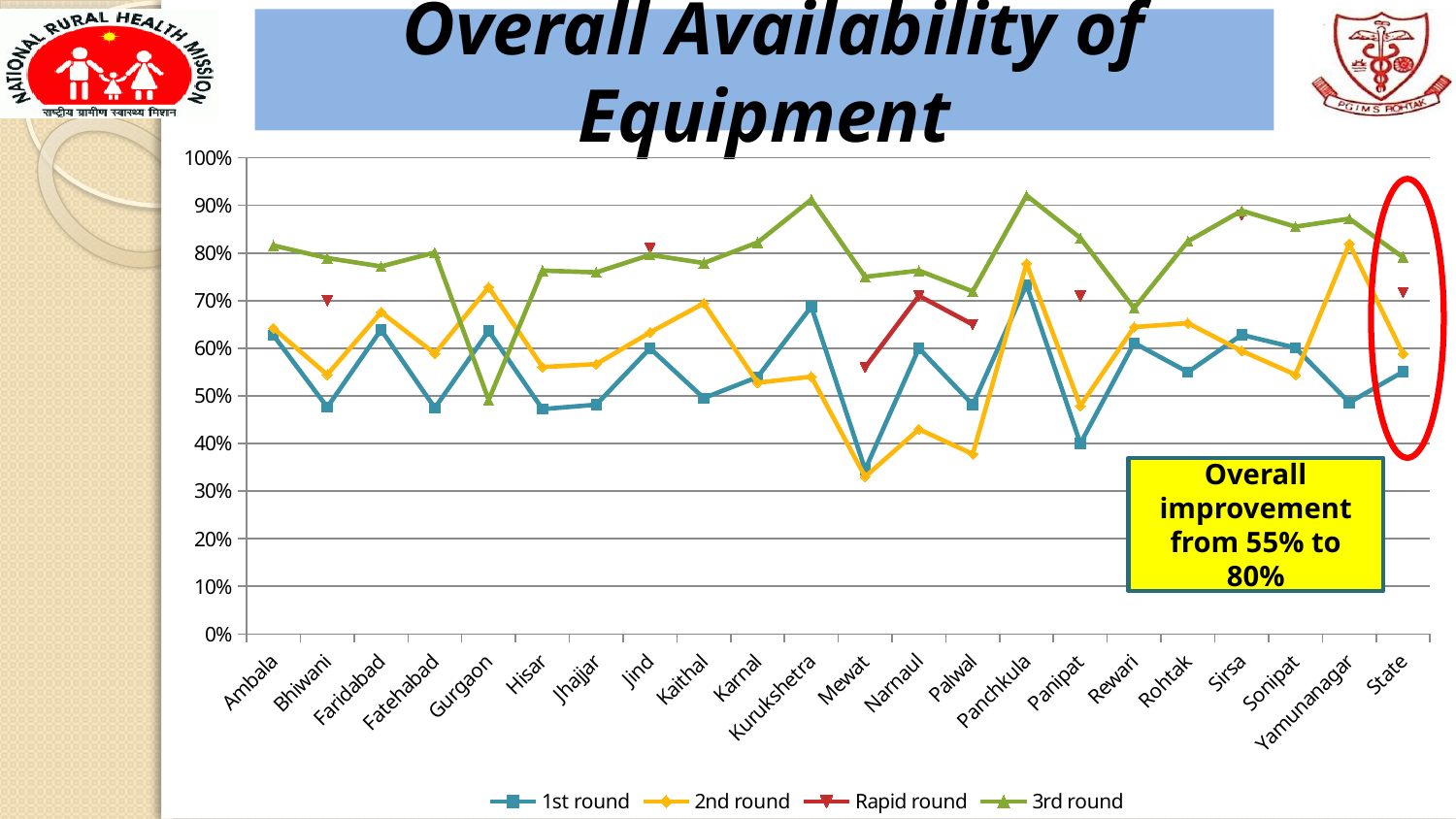
Which category has the highest value for the 2nd round series? Yamunanagar At Narnaul, which is larger: the Rapid round value or the 1st round value? Rapid round Which category has the lowest value for the 1st round series? Mewat According to the yellow text box, the overall improvement is from what to what? from 55% to 80% Is the 1st round value for Panipat greater or less than 50%? less Is the 1st round value for Mewat greater or less than 40%? less How many series does the legend list? 4 Is the 3rd round value for State greater or less than 70%? greater Which category has the lowest value for the 3rd round series? Gurgaon How many categories are shown along the x axis? 22 At Gurgaon, which is larger: the 1st round value or the 3rd round value? 1st round What kind of chart is shown on the slide? line chart